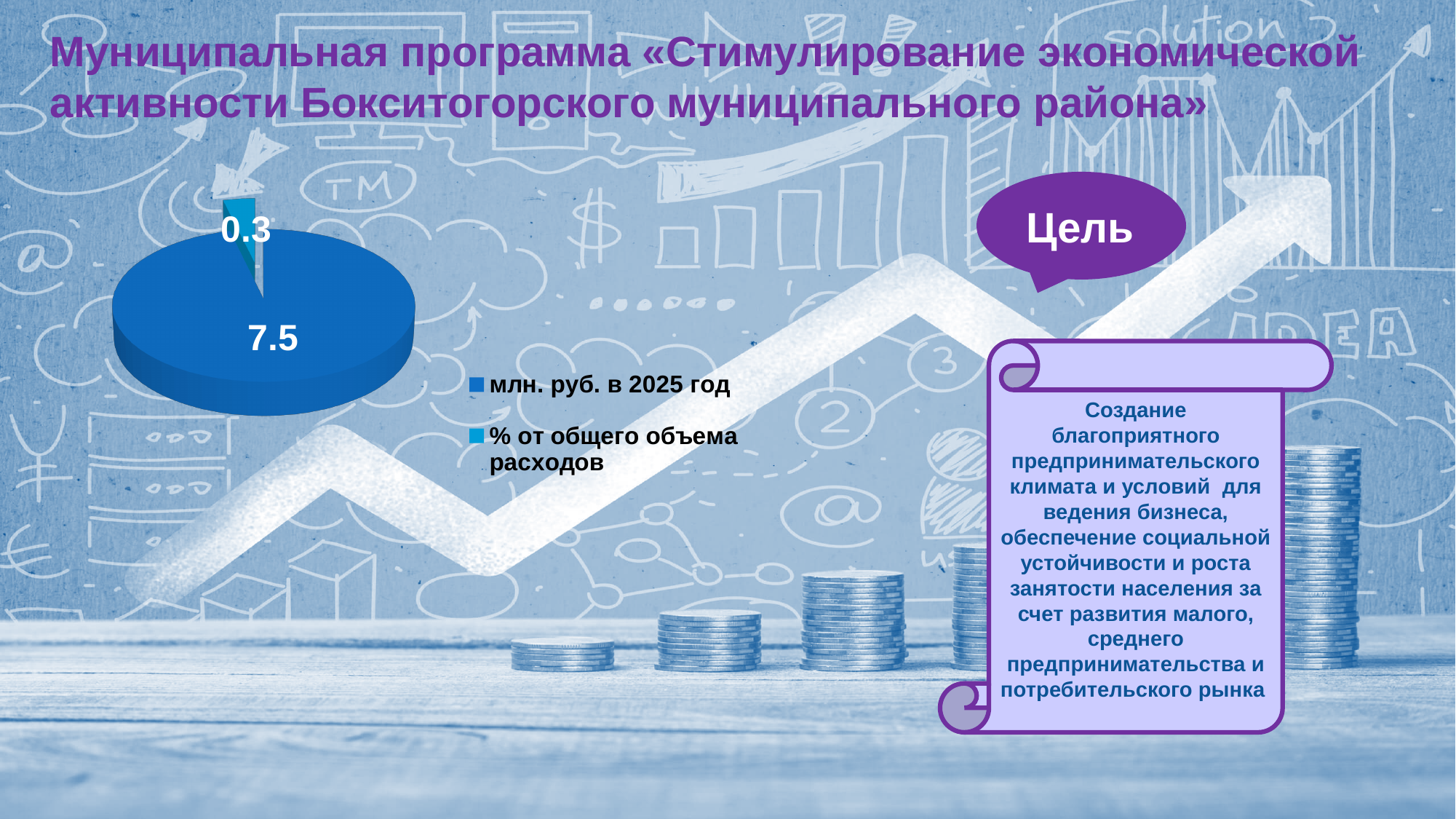
What type of chart is shown on the slide? pie chart Which slice of the pie chart is the largest? млн. руб. в 2025 год What colour is the slice labelled 7.5 in the pie chart? dark blue How many slices does the pie chart have? 2 What is the second legend entry of the pie chart? % от общего объема расходов What value is shown for "млн. руб. в 2025 год" in the pie chart? 7.5 What value is shown for "% от общего объема расходов" in the pie chart? 0.3 What is the difference between the two values shown in the pie chart? 7.2 Which slice of the pie chart is the smallest? % от общего объема расходов Which is larger in the pie chart: "млн. руб. в 2025 год" or "% от общего объема расходов"? млн. руб. в 2025 год How many entries does the legend of the pie chart list? 2